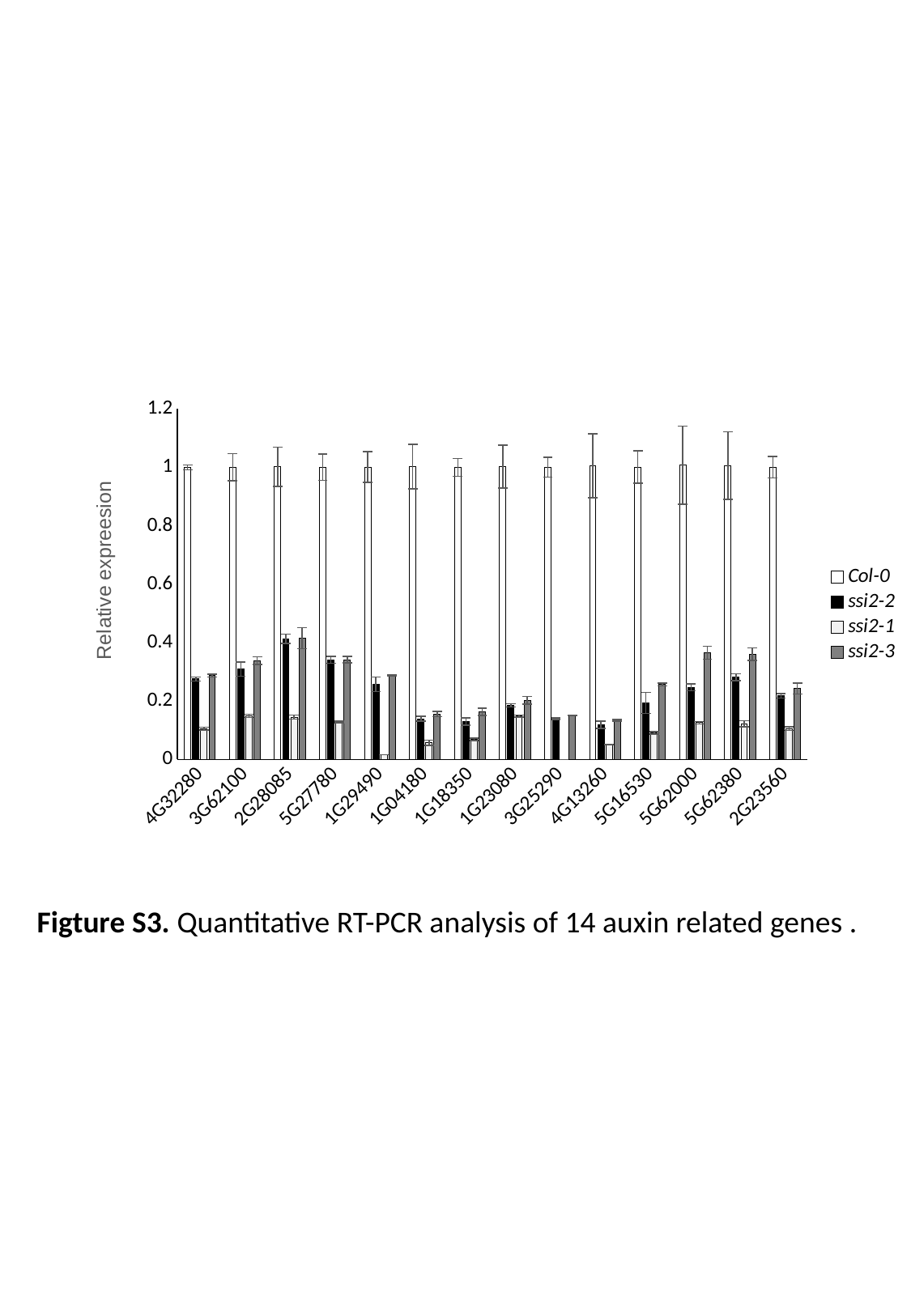
Is the ssi2-3 value for gene 5G62000 greater or less than 0.2? greater Which series is shown with black bars in the chart? ssi2-2 For gene 2G28085, which is larger: the ssi2-2 value or the ssi2-1 value? ssi2-2 What kind of chart is shown on the slide? bar chart What is the label of the y axis of the chart? Relative expreesion Is the ssi2-2 value for gene 2G28085 greater or less than 0.2? greater Is the ssi2-2 value for gene 4G13260 greater or less than 0.2? less How many series does the chart legend list? 4 Which series has the highest relative expression for every gene in the chart? Col-0 What is the relative expression value for Col-0 at gene 4G32280? 1 How many genes (categories) are shown on the x axis of the chart? 14